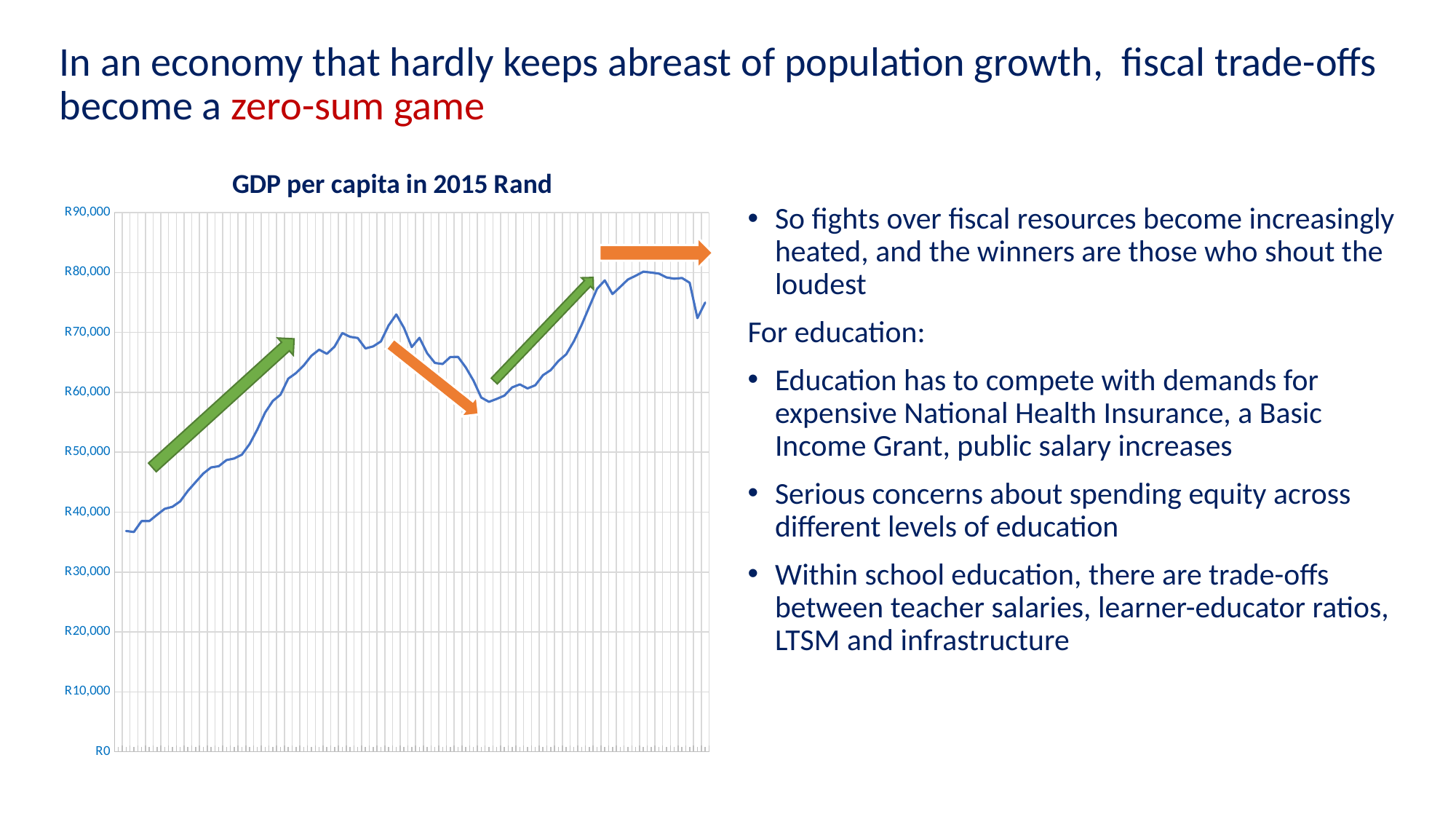
Is the value at the last (rightmost) point of the line greater or less than R70,000? greater What is the highest value labelled on the vertical axis of the chart? R90,000 What is the title of the chart? GDP per capita in 2015 Rand Which is larger, the value at the first point of the line or the value at the last point of the line? the last point Is the value at the first (leftmost) point of the line greater or less than R30,000? greater Is the lowest point of the line greater or less than R40,000? less Overall, do the values in the chart rise or fall from left to right along the x axis? rise What kind of chart is shown on the slide? line chart